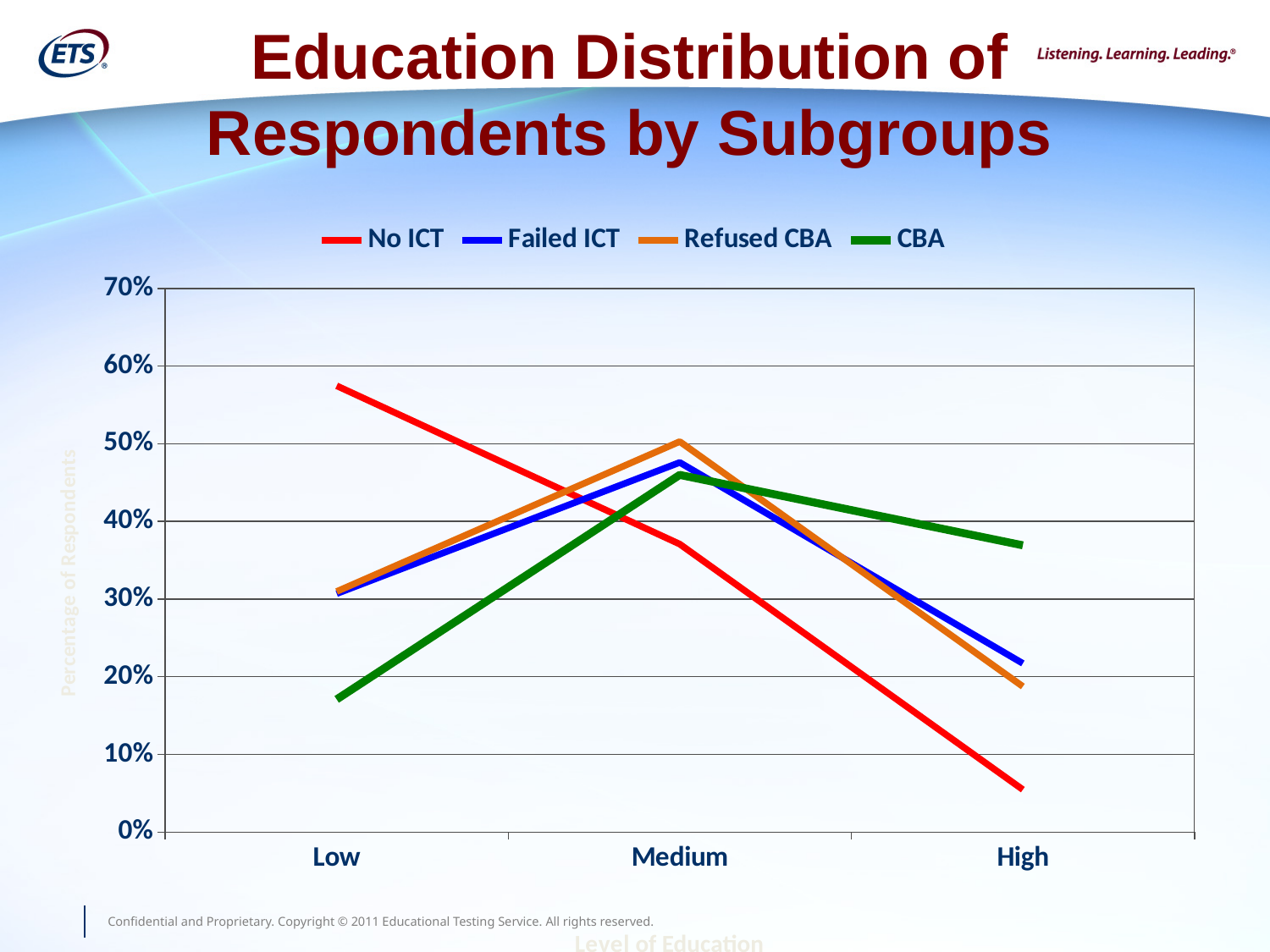
What colour is the CBA line in the legend? Green At High, which is larger: CBA or No ICT? CBA How many series does the legend list? 4 Is the value for CBA at Low greater or less than 20%? less What kind of chart is shown on the slide? Line chart Which series has the highest value at Low? No ICT Is the value for Refused CBA at Medium greater or less than 40%? greater Which series has the lowest value at High? No ICT How many education level categories are shown on the x axis? 3 Does the No ICT line rise or fall from Low to High? Fall Is the value for No ICT at High greater or less than 10%? less